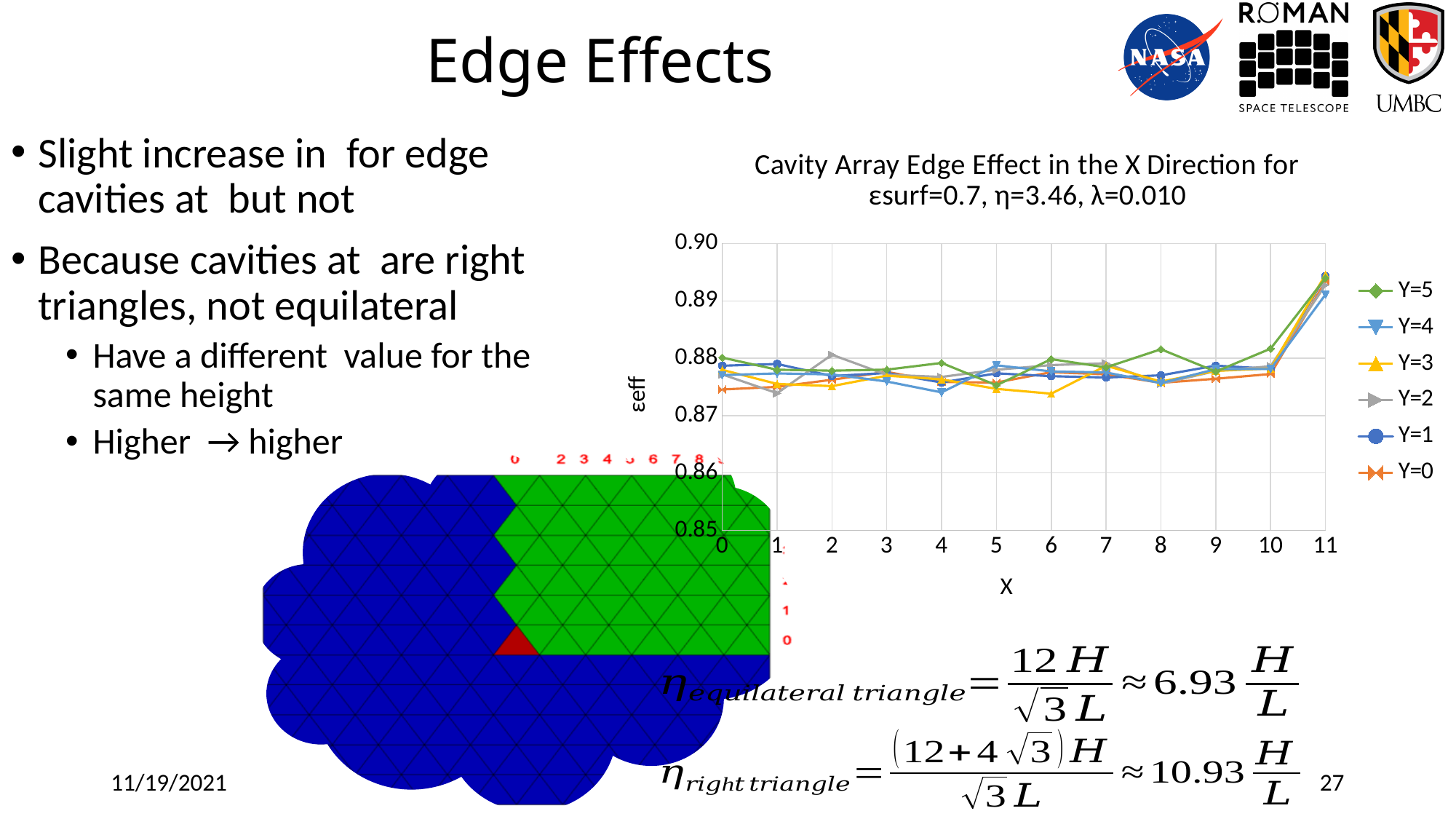
At X=8, which series has the larger εeff value: Y=5 or Y=0? Y=5 Is the εeff value for Y=5 at X=11 greater or less than 0.89? greater How many series does the legend of the chart list? 6 Is the εeff value for Y=0 at X=0 greater or less than 0.88? less At which X value does the Y=5 series reach its highest εeff? 11 Which is larger for the Y=5 series: the εeff value at X=0 or at X=11? X=11 How many X values are plotted along the x axis of the chart? 12 What kind of chart is shown on the slide? line chart Do the εeff values rise or fall between X=10 and X=11? rise What is the title of the chart? Cavity Array Edge Effect in the X Direction for εsurf=0.7, η=3.46, λ=0.010 What is the label of the y axis of the chart? εeff Is the εeff value for Y=3 at X=6 greater or less than 0.88? less